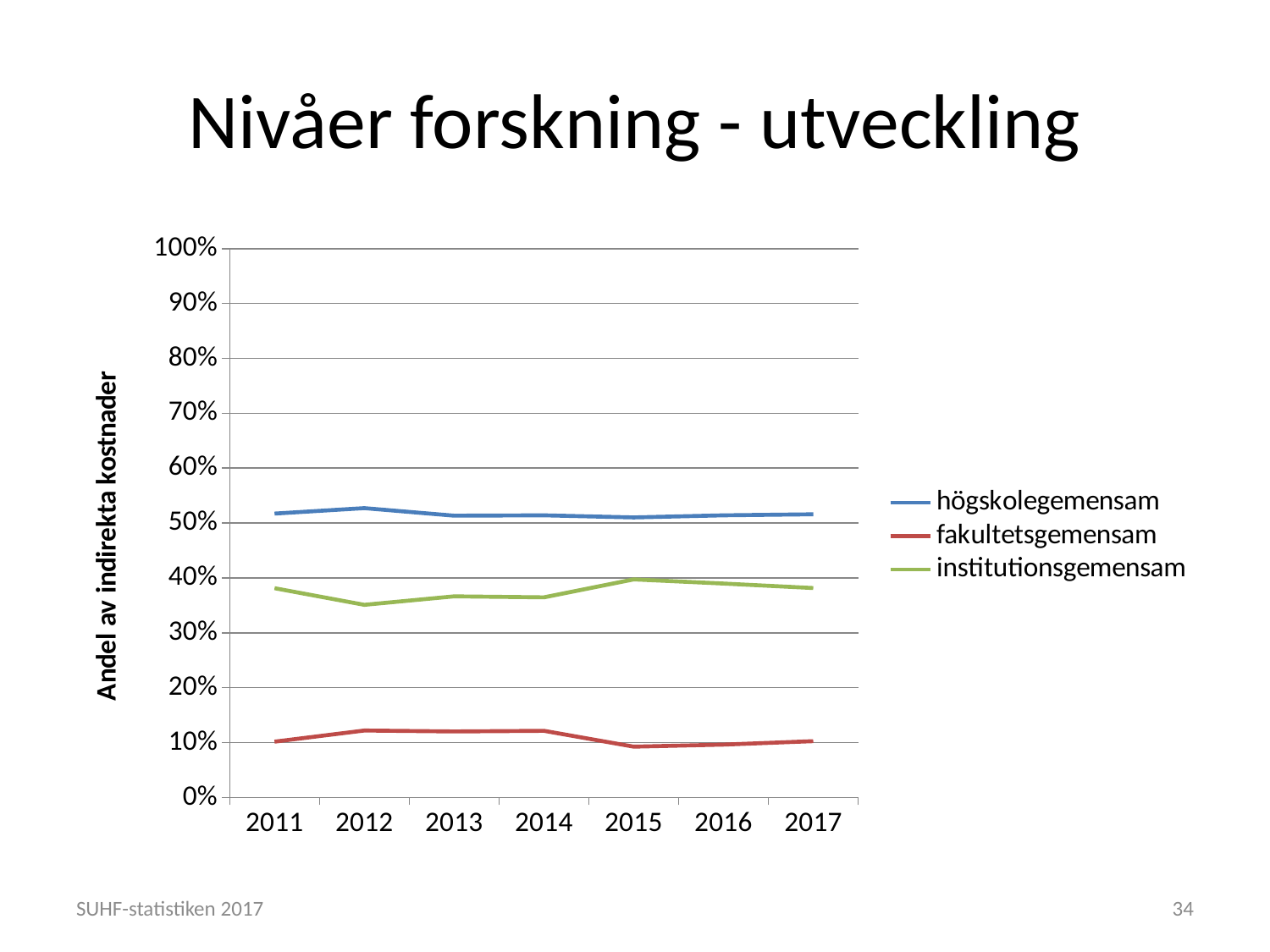
Is the value for högskolegemensam in 2012 greater or less than 50%? greater What is the title of the vertical axis? Andel av indirekta kostnader What kind of chart is shown on the slide? line chart Is the value for institutionsgemensam in 2015 greater or less than 30%? greater How many series does the legend list? 3 Does the value for fakultetsgemensam rise or fall from 2014 to 2015? fall Which series has the lowest value in 2011? fakultetsgemensam How many years are shown on the x axis? 7 In 2017, which is larger: högskolegemensam or institutionsgemensam? högskolegemensam Is the value for institutionsgemensam in 2012 greater or less than 40%? less Which series has the highest value in 2014? högskolegemensam